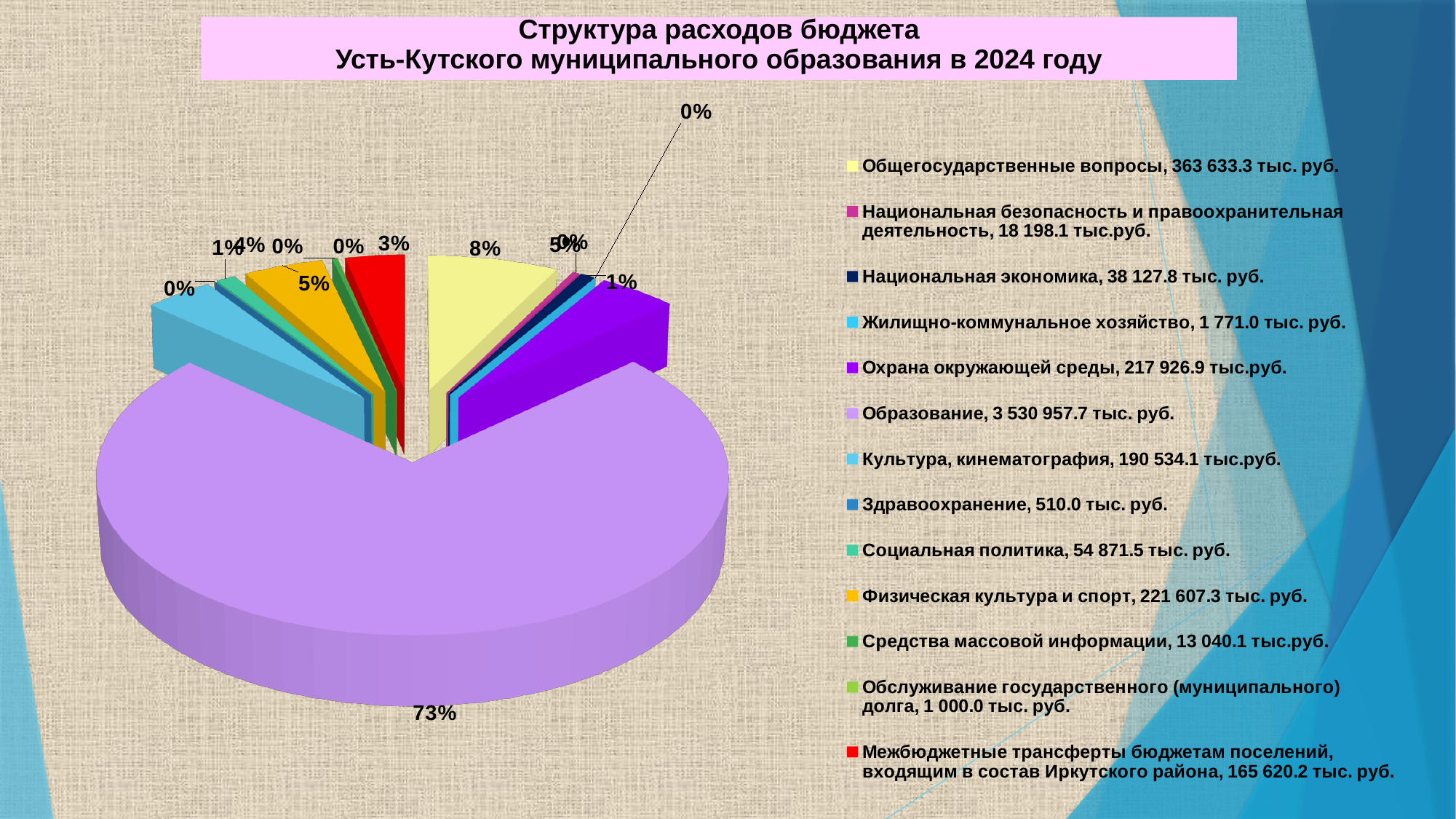
Which is larger: Физическая культура и спорт or Охрана окружающей среды? Физическая культура и спорт Which category has the largest expenditure? Образование What is the difference between Физическая культура и спорт (221 607.3) and Охрана окружающей среды (217 926.9)? 3 680.4 тыс. руб. What share of the pie does Общегосударственные вопросы take? 8% What share of the pie does Образование take? 73% What value is given in the legend for Здравоохранение? 510.0 тыс. руб. Which category has the smallest expenditure? Здравоохранение What is the title of the chart? Структура расходов бюджета Усть-Кутского муниципального образования в 2024 году What value is given in the legend for Образование? 3 530 957.7 тыс. руб. How many categories does the legend of the pie chart list? 13 What kind of chart is shown on the slide? pie chart What value is given in the legend for Охрана окружающей среды? 217 926.9 тыс.руб.